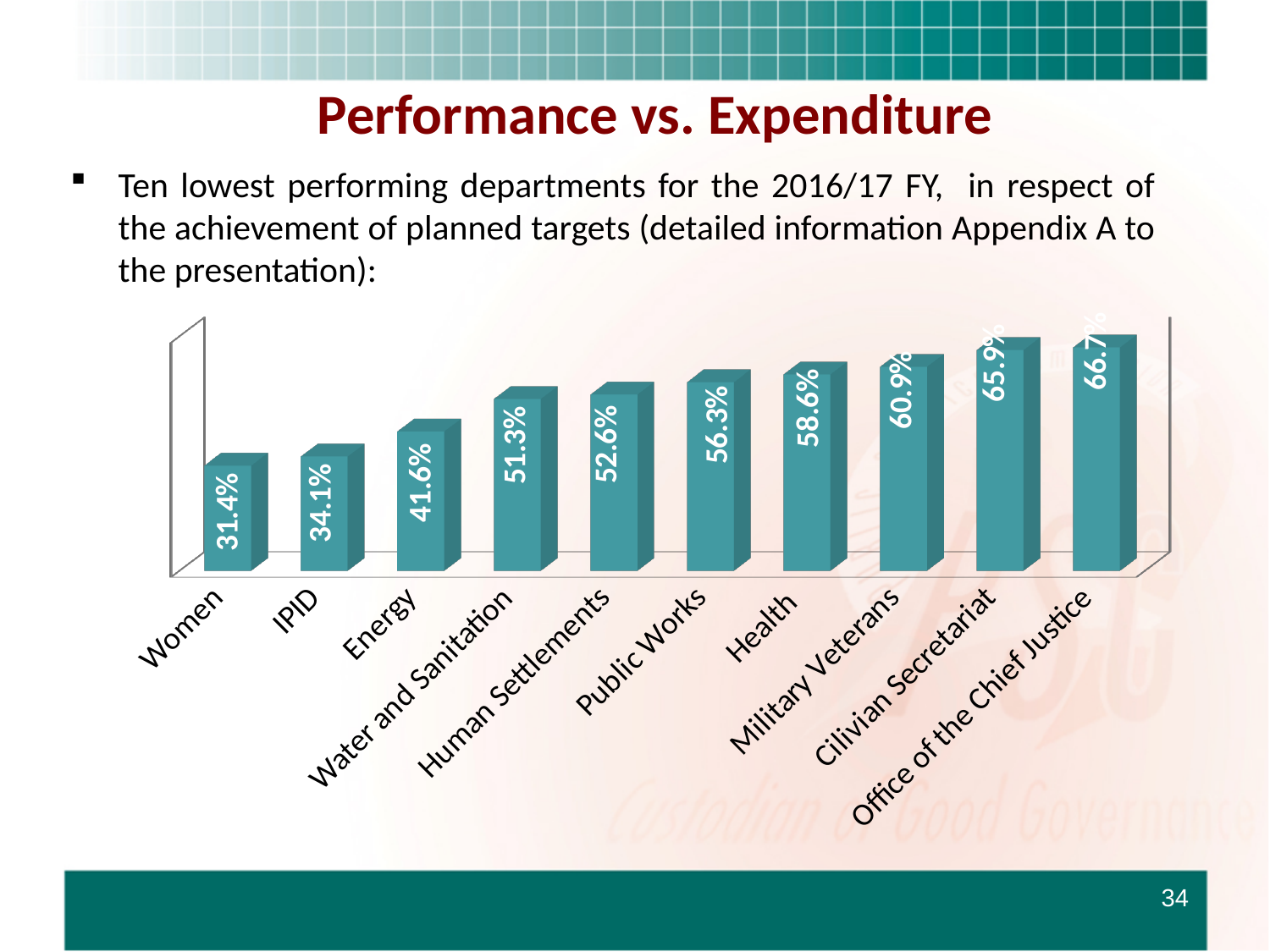
What is the title of the slide containing the chart? Performance vs. Expenditure What is the value for Health? 58.6% Which is larger, the value for Military Veterans or the value for Water and Sanitation? Military Veterans How many departments are shown in the chart? 10 What is the difference between the values for Public Works and IPID? 22.2% What is the value for Civilian Secretariat? 65.9% What is the value for Women? 31.4% What is the value for Energy? 41.6% Do the values rise or fall from left to right along the x axis? Rise What kind of chart is shown on the slide? Bar chart Which department has the highest value? Office of the Chief Justice Which department has the lowest value? Women